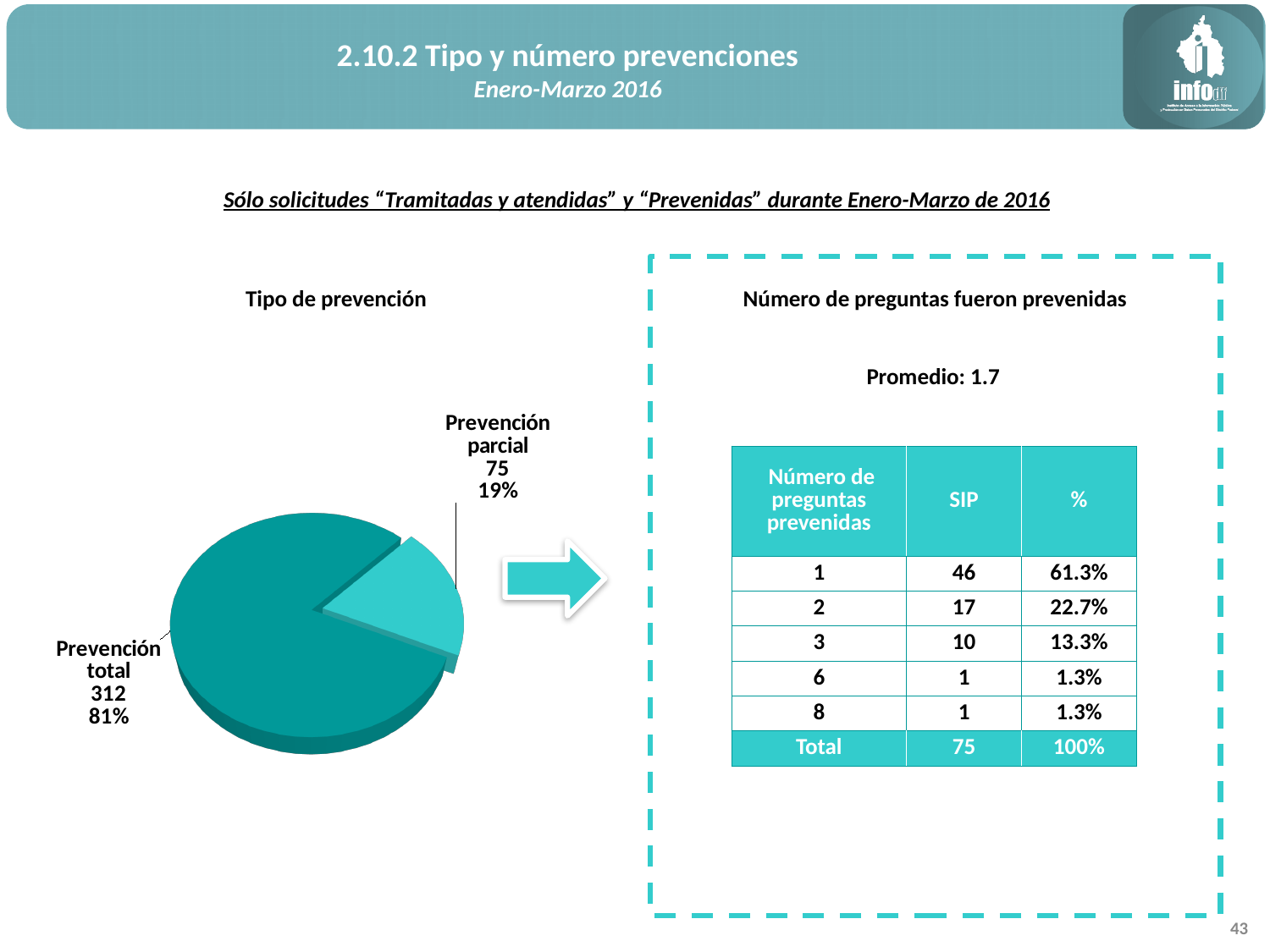
What kind of chart is shown under the title "Tipo de prevención"? Pie chart In the "Tipo de prevención" pie chart, what is the difference between the values for Prevención total and Prevención parcial? 237 In the "Tipo de prevención" pie chart, what is the value for Prevención total? 312 In the "Tipo de prevención" pie chart, what share of the pie does Prevención total represent? 81% In the "Tipo de prevención" pie chart, which is larger: Prevención total or Prevención parcial? Prevención total In the "Tipo de prevención" pie chart, what share of the pie does Prevención parcial represent? 19% What is the title of the pie chart on the slide? Tipo de prevención In the "Tipo de prevención" pie chart, what is the value for Prevención parcial? 75 How many slices does the "Tipo de prevención" pie chart have? 2 Which slice of the "Tipo de prevención" pie chart is the largest? Prevención total Which slice of the "Tipo de prevención" pie chart is the smallest? Prevención parcial What is the combined total of the two slices in the "Tipo de prevención" pie chart? 387